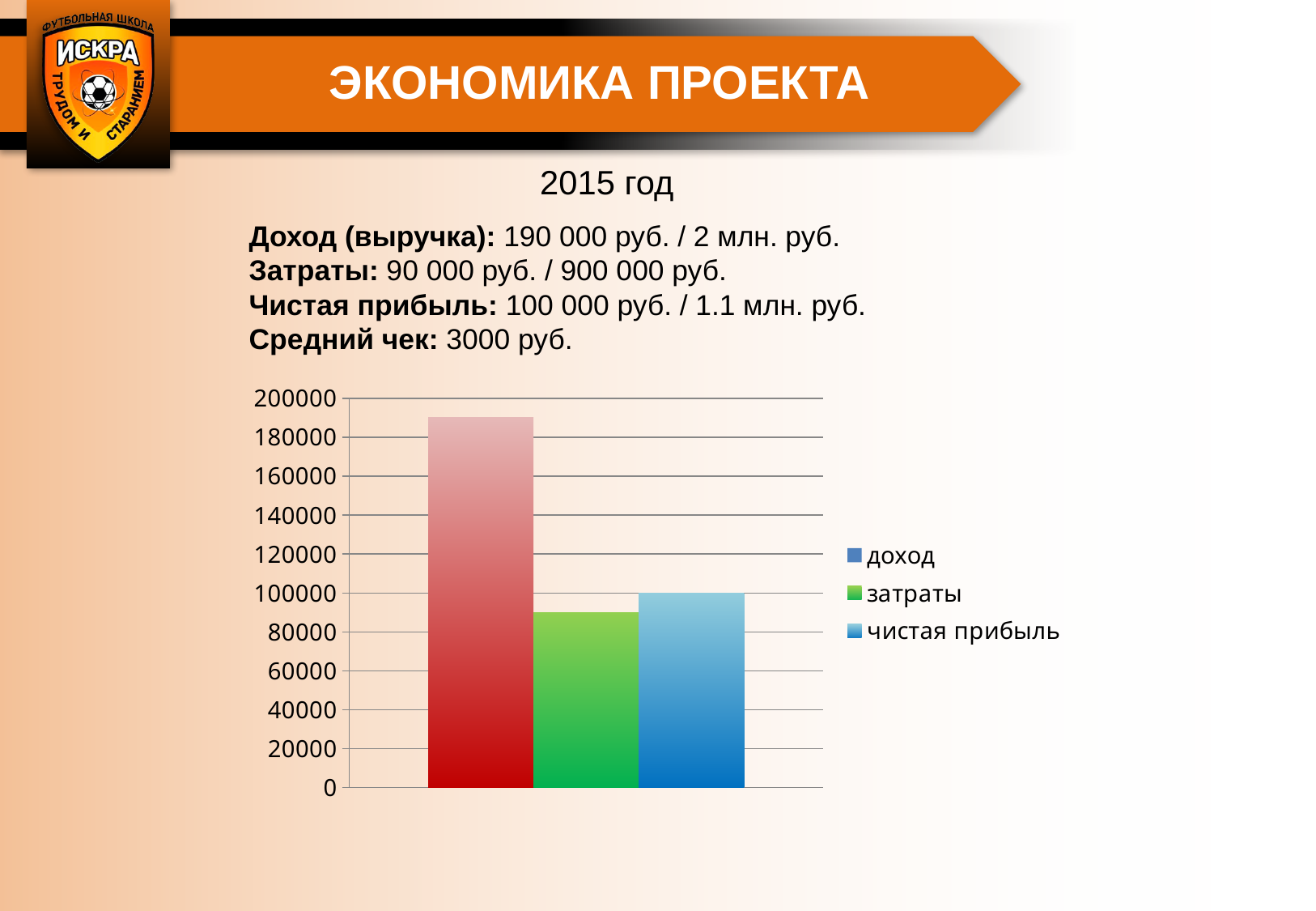
Is the value for доход greater or less than 180000? greater Is the value for доход greater or less than 200000? less What is the value of the чистая прибыль bar? 100000 Which series has the lowest bar in the chart? затраты How many series does the chart legend list? 3 What colour is the затраты bar in the chart? green How many bars are plotted in the chart? 3 Is the value for затраты greater or less than 100000? less What kind of chart is shown on the slide? bar chart Which series has the highest bar in the chart? доход Which is larger, the bar for чистая прибыль or the bar for затраты? чистая прибыль Which is larger, the bar for доход or the bar for затраты? доход